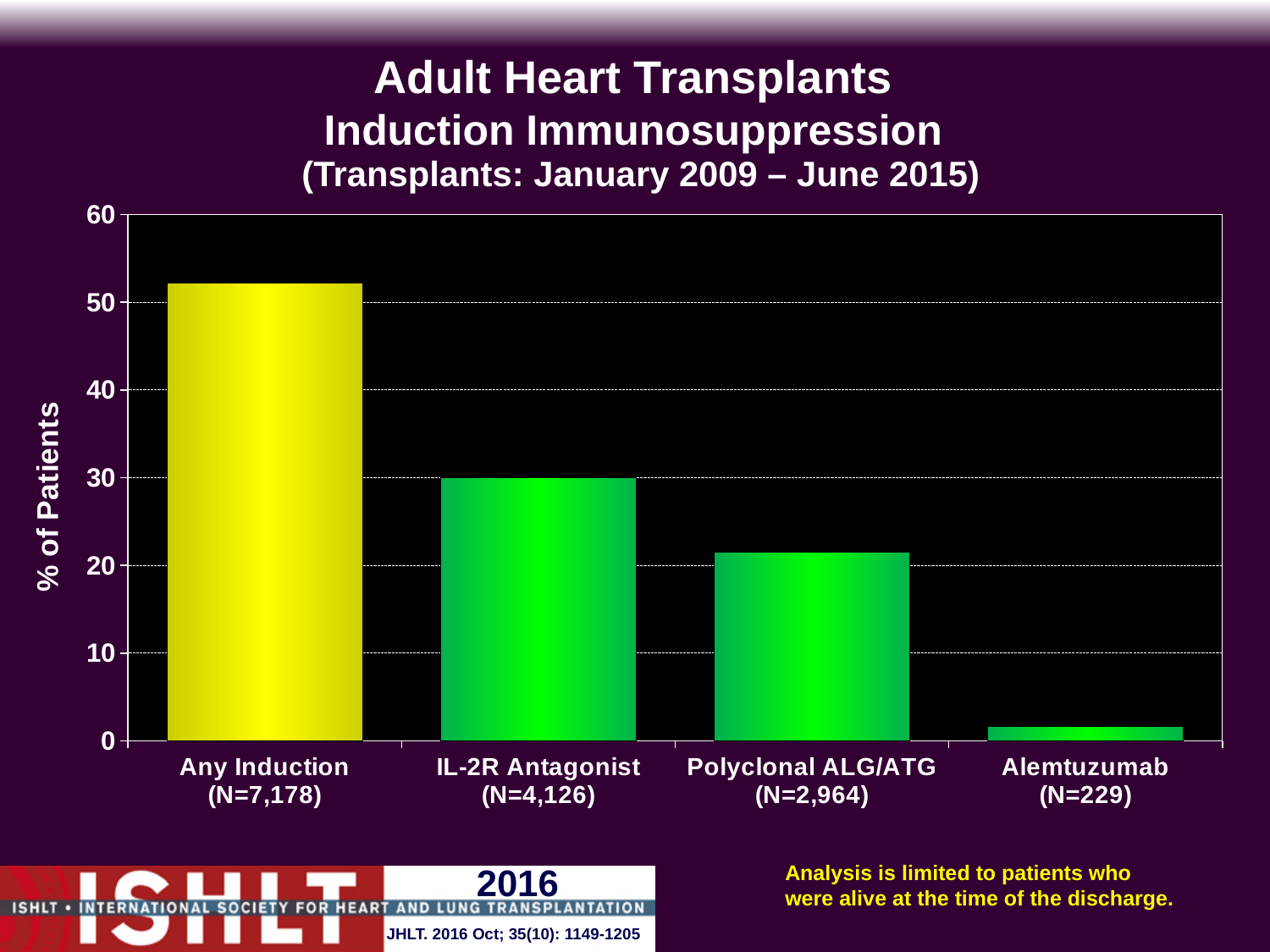
Which is larger, the value for IL-2R Antagonist or the value for Polyclonal ALG/ATG? IL-2R Antagonist What is the N shown for the Polyclonal ALG/ATG category? N=2,964 Is the value for Alemtuzumab greater or less than 10? less What kind of chart is shown on the slide? bar chart Is the value for Polyclonal ALG/ATG greater or less than 20? greater Which category has the highest percentage of patients? Any Induction Which category has the lowest percentage of patients? Alemtuzumab Is the value for Any Induction greater or less than 50? greater How many categories are plotted on the x axis? 4 What is the label of the y axis? % of Patients Do the bar values rise or fall from left to right along the x axis? fall